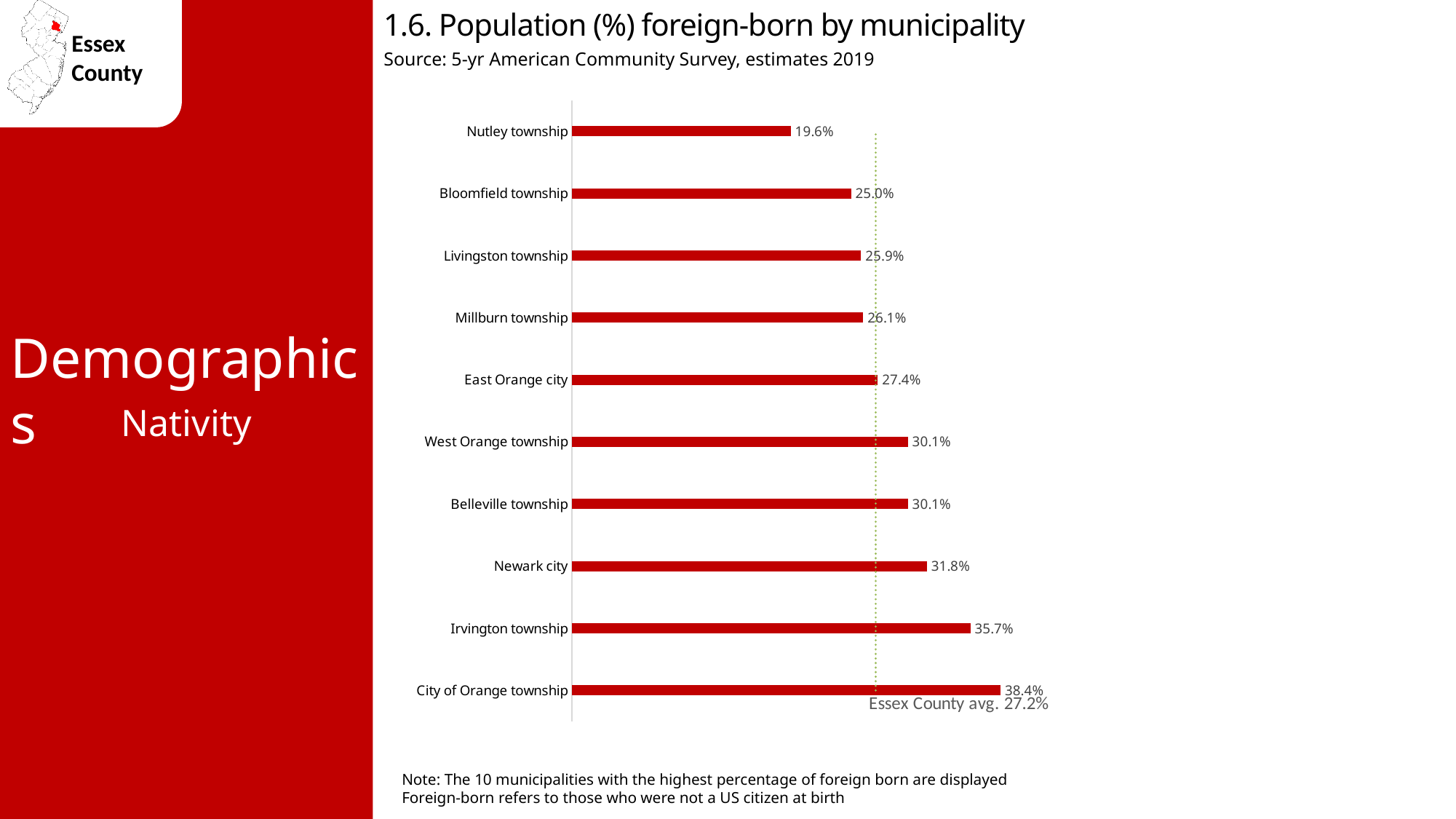
What is the percentage of foreign-born population in Newark city? 31.8% How many municipalities are shown in the chart? 10 What is the difference in foreign-born percentage between Irvington township and Newark city? 3.9% What is the percentage of foreign-born population in Nutley township? 19.6% What is the Essex County average percentage of foreign-born population shown on the chart? 27.2% What is the difference in foreign-born percentage between City of Orange township and Nutley township? 18.8% What type of chart is used to show the foreign-born population by municipality? Bar chart What is the source of the data shown in the chart? 5-yr American Community Survey, estimates 2019 Which has a higher foreign-born percentage, East Orange city or Millburn township? East Orange city Which municipality has the highest percentage of foreign-born population? City of Orange township What is the percentage of foreign-born population in Irvington township? 35.7% Which municipality has the lowest percentage of foreign-born population? Nutley township